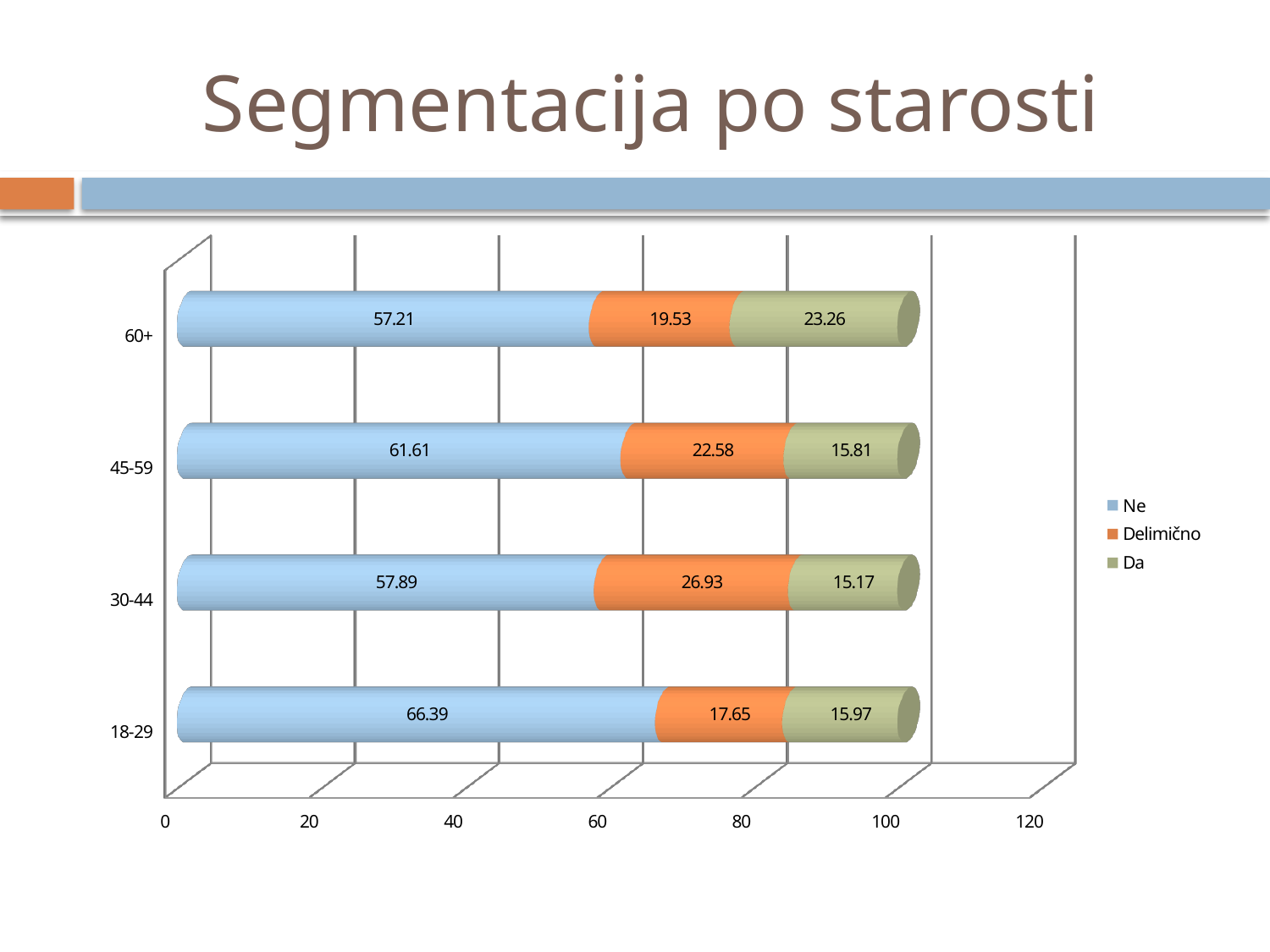
Which is larger: the Delimično value for 45-59 or the Delimično value for 18-29? 45-59 What kind of chart is shown on the slide? Stacked bar chart What is the value of the Da series for the 60+ age group? 23.26 Which age group has the highest value for the Ne series? 18-29 What is the difference between the Ne values for the 18-29 and 60+ age groups? 9.18 How many series does the legend list? 3 What is the value of the Ne series for the 18-29 age group? 66.39 Which age group has the lowest value for the Da series? 30-44 What is the total of the stacked bar for the 45-59 age group? 100.00 What is the value of the Delimično series for the 30-44 age group? 26.93 Is the Ne value for the 45-59 age group greater or less than 60? greater How many age groups are shown on the chart? 4